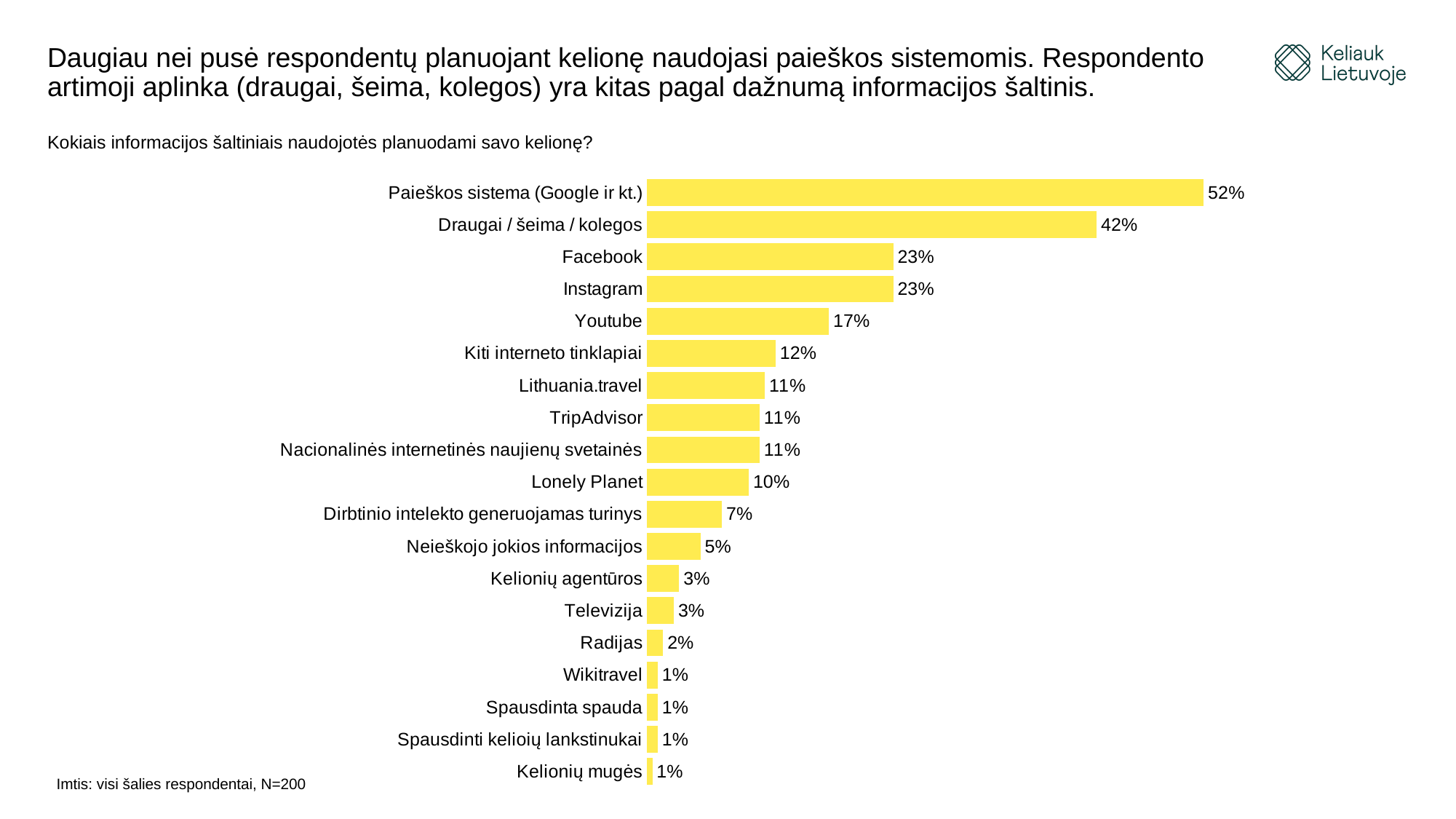
What is the value for Dirbtinio intelekto generuojamas turinys? 7% How many information sources (categories) are shown in the chart? 19 What is the sample size stated on the slide? N=200 What is the value for Draugai / šeima / kolegos? 42% What is the value for Youtube? 17% What is the value for Radijas? 2% What percentage of respondents used Paieškos sistema (Google ir kt.) when planning their trip? 52% Which information source has the highest value? Paieškos sistema (Google ir kt.) What is the difference between the values for Facebook and Youtube? 6% What kind of chart is shown on the slide? bar chart Which has a larger value, Kiti interneto tinklapiai or Lonely Planet? Kiti interneto tinklapiai What is the difference between the values for Paieškos sistema (Google ir kt.) and Draugai / šeima / kolegos? 10%